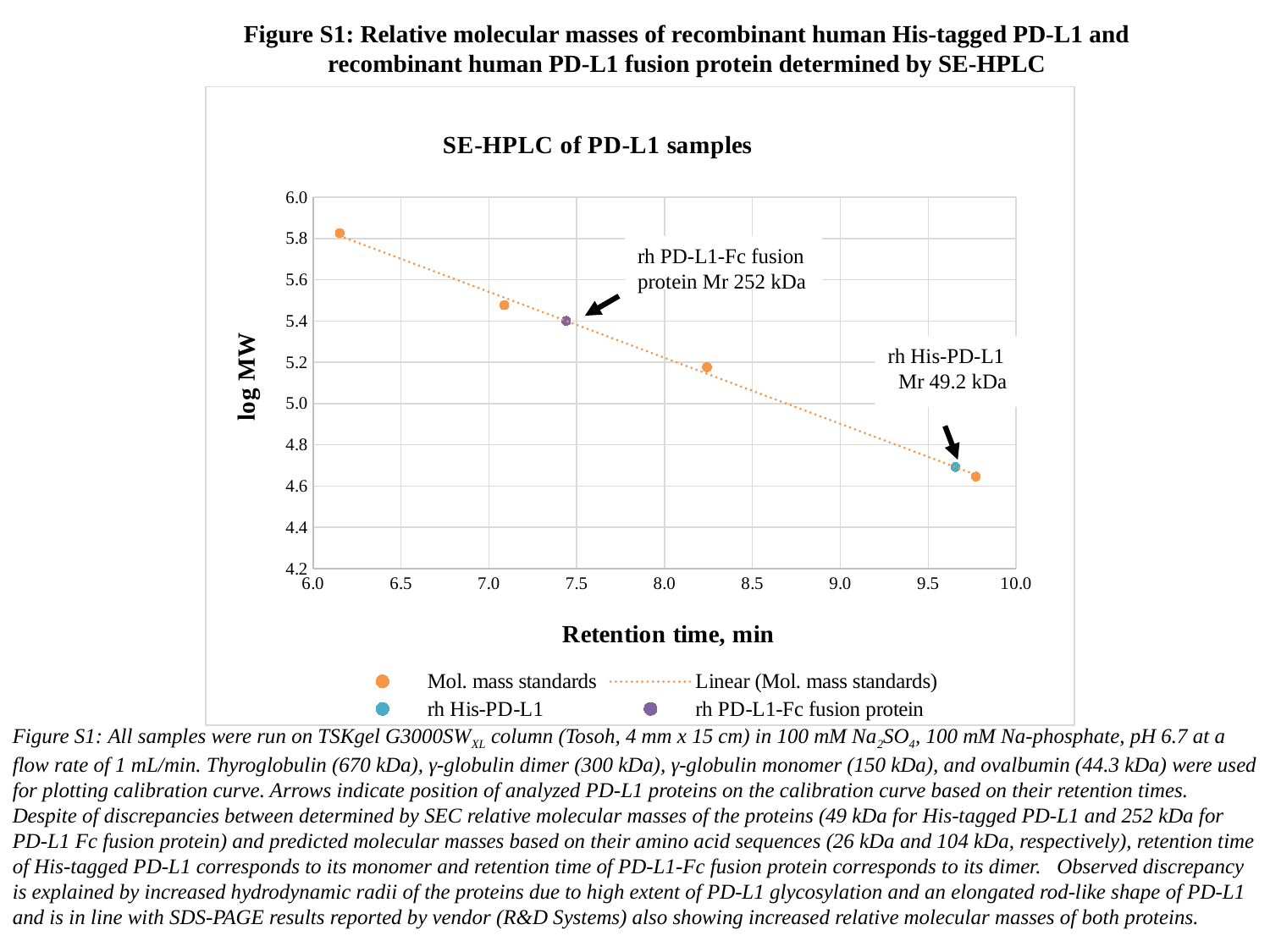
What Mr value is annotated on the chart for the rh PD-L1-Fc fusion protein? 252 kDa How many entries does the chart legend list? 4 What Mr value is annotated on the chart for rh His-PD-L1? 49.2 kDa Do the log MW values rise or fall as retention time increases along the x axis? fall Is the log MW value for rh His-PD-L1 greater or less than 4.8? less What type of chart is shown on the slide? scatter chart What is the title of the chart? SE-HPLC of PD-L1 samples How many Mol. mass standards points are plotted on the chart? 4 Is the log MW value for the rh PD-L1-Fc fusion protein greater or less than 5.2? greater Which series contains the point with the highest log MW on the chart? Mol. mass standards Which has the higher log MW, rh His-PD-L1 or rh PD-L1-Fc fusion protein? rh PD-L1-Fc fusion protein What is the label of the x axis? Retention time, min